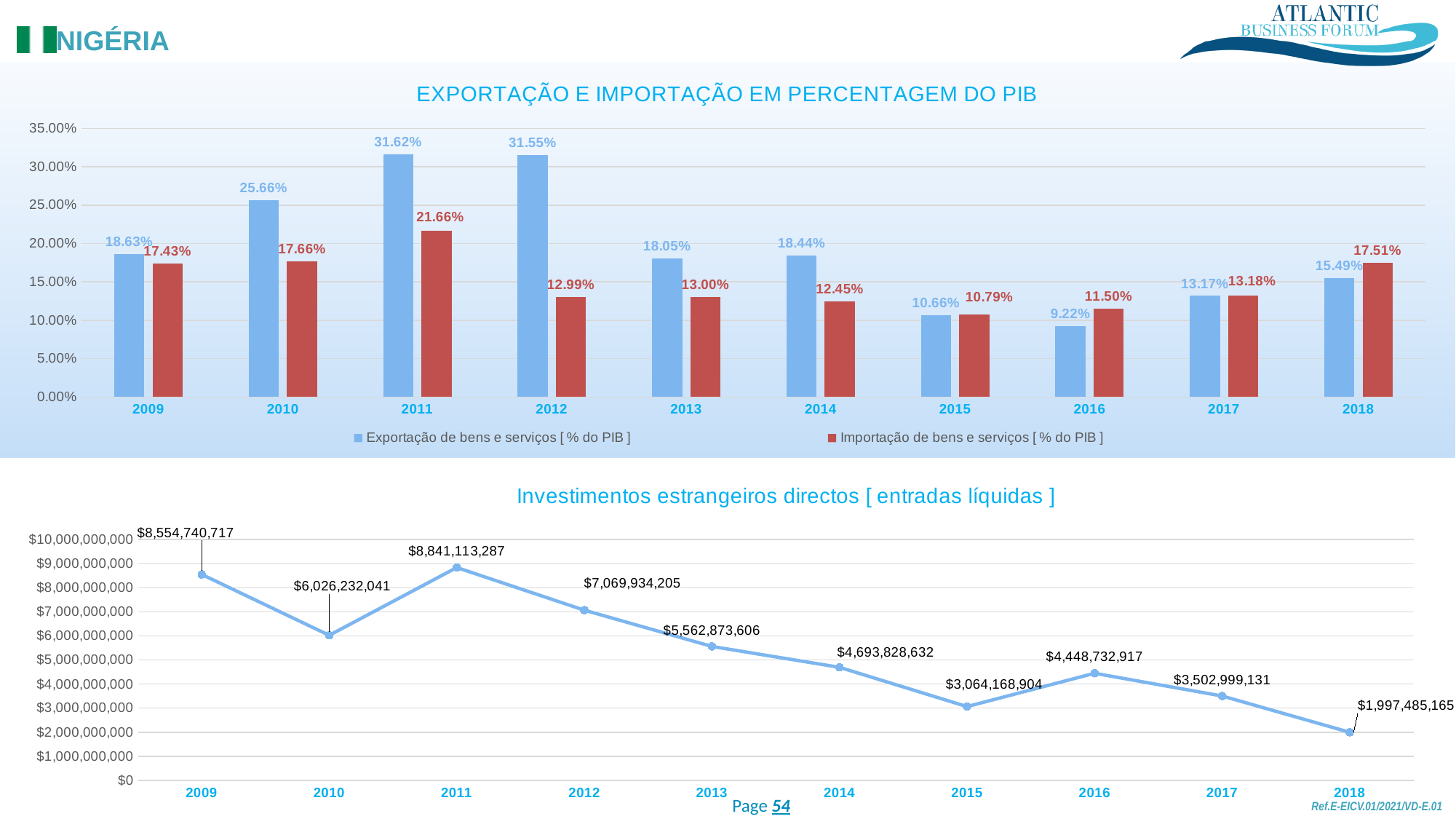
What kind of chart is 'EXPORTAÇÃO E IMPORTAÇÃO EM PERCENTAGEM DO PIB'? Bar chart In the chart 'EXPORTAÇÃO E IMPORTAÇÃO EM PERCENTAGEM DO PIB', what is the value of Exportação de bens e serviços for 2011? 31.62% In the chart 'Investimentos estrangeiros directos [ entradas líquidas ]', which year has the highest value? 2011 In the chart 'EXPORTAÇÃO E IMPORTAÇÃO EM PERCENTAGEM DO PIB', which year has the lowest Exportação de bens e serviços value? 2016 In the chart 'Investimentos estrangeiros directos [ entradas líquidas ]', what is the difference between the 2009 and 2010 values? $2,528,508,676 In the chart 'EXPORTAÇÃO E IMPORTAÇÃO EM PERCENTAGEM DO PIB', what is the difference between the Exportação and Importação values in 2011? 9.96 percentage points In the chart 'EXPORTAÇÃO E IMPORTAÇÃO EM PERCENTAGEM DO PIB', which is larger in 2016: Exportação or Importação? Importação In the chart 'Investimentos estrangeiros directos [ entradas líquidas ]', what is the value for 2014? $4,693,828,632 How many years are plotted in the chart 'Investimentos estrangeiros directos [ entradas líquidas ]'? 10 In the chart 'EXPORTAÇÃO E IMPORTAÇÃO EM PERCENTAGEM DO PIB', which year has the highest Importação de bens e serviços value? 2011 How many series does the legend of the chart 'EXPORTAÇÃO E IMPORTAÇÃO EM PERCENTAGEM DO PIB' list? 2 In the chart 'EXPORTAÇÃO E IMPORTAÇÃO EM PERCENTAGEM DO PIB', what is the value of Importação de bens e serviços for 2018? 17.51%